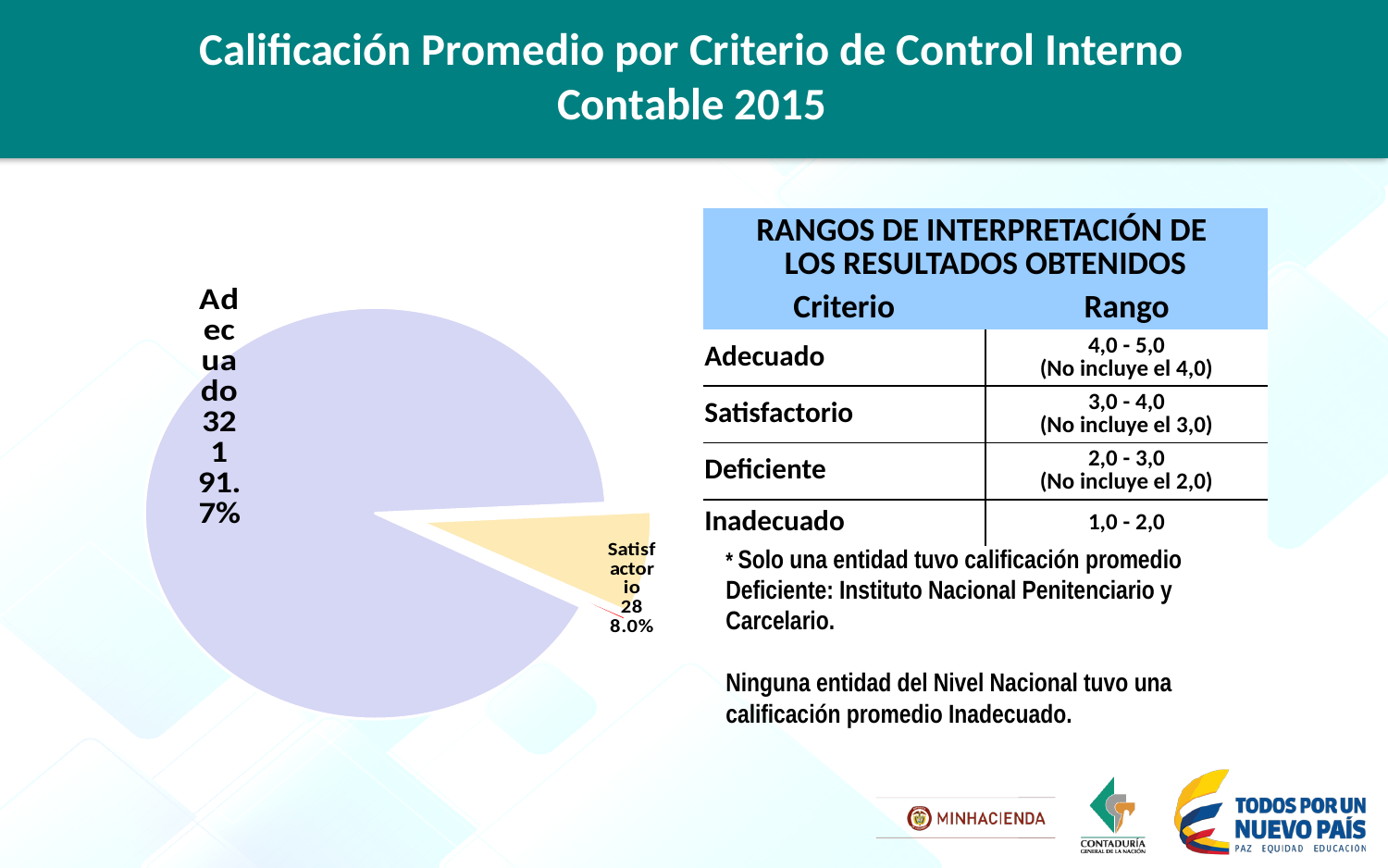
What percentage of the pie does the Satisfactorio slice represent? 8.0% What percentage of the pie does the Adecuado slice represent? 91.7% What is the total of the counts shown on the two pie slices? 349 What is the count shown for the Satisfactorio slice? 28 What is the difference between the counts for Adecuado and Satisfactorio? 293 How many slices does the pie chart have? 3 What is the title of the slide containing the pie chart? Calificación Promedio por Criterio de Control Interno Contable 2015 What is the count shown for the Adecuado slice? 321 Which slice of the pie chart is the largest? Adecuado Which has a larger count, Adecuado or Satisfactorio? Adecuado What kind of chart is shown on the slide? pie chart